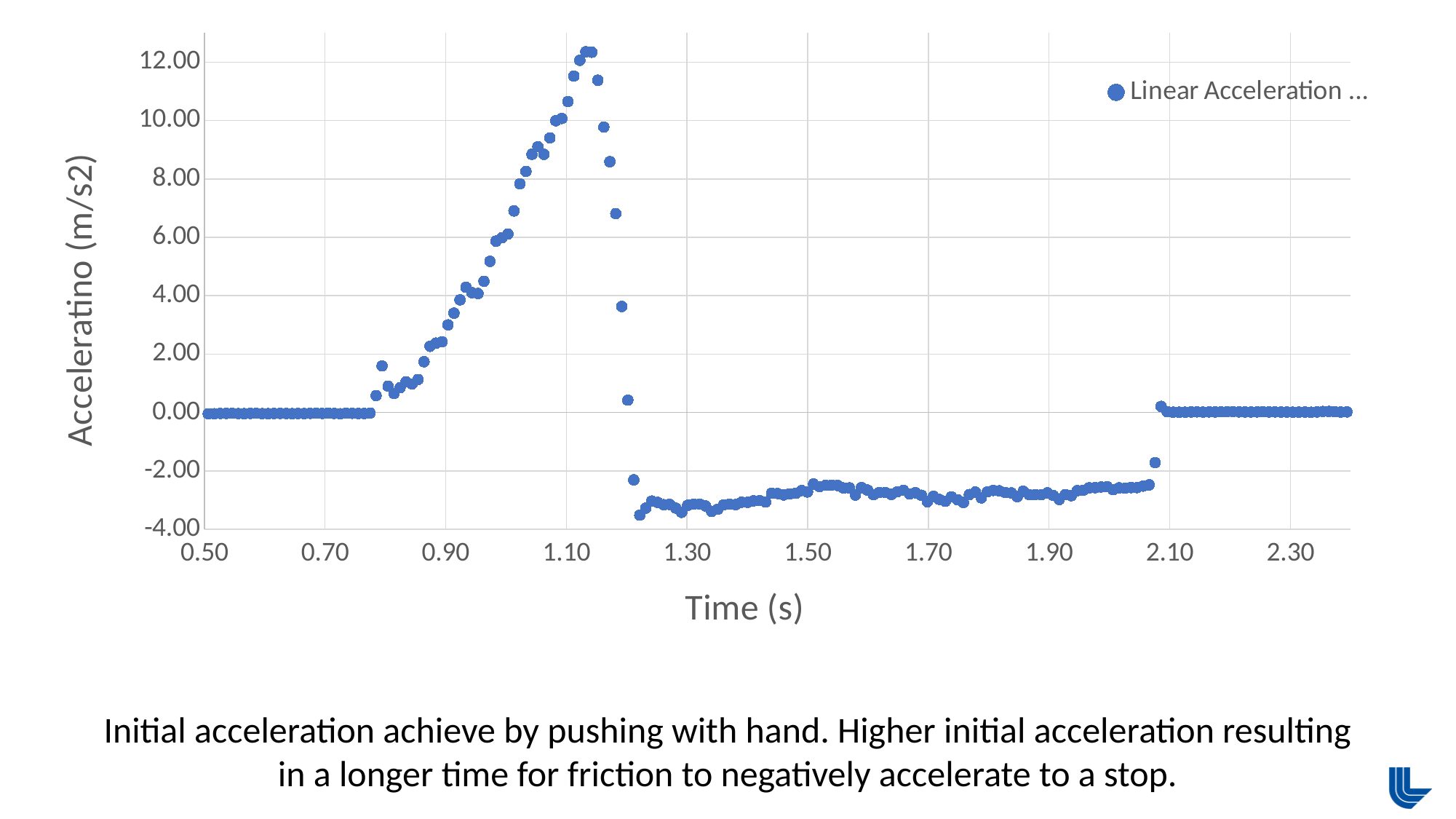
What is the title of the x axis? Time (s) How many series does the legend list? 1 Is the lowest plotted acceleration value greater or less than -4.00? greater What is the title of the y axis? Acceleratino (m/s2) Is the acceleration value at 0.90 s greater or less than 6.00? less Is the highest plotted acceleration value greater or less than 10.00? greater Do the acceleration values rise or fall as time goes from 0.80 s to 1.10 s? rise What kind of chart is shown on the slide? scatter chart Which has the larger acceleration value, the point at 1.00 s or the point at 1.50 s? 1.00 s Does the peak acceleration occur before or after 1.30 s? before